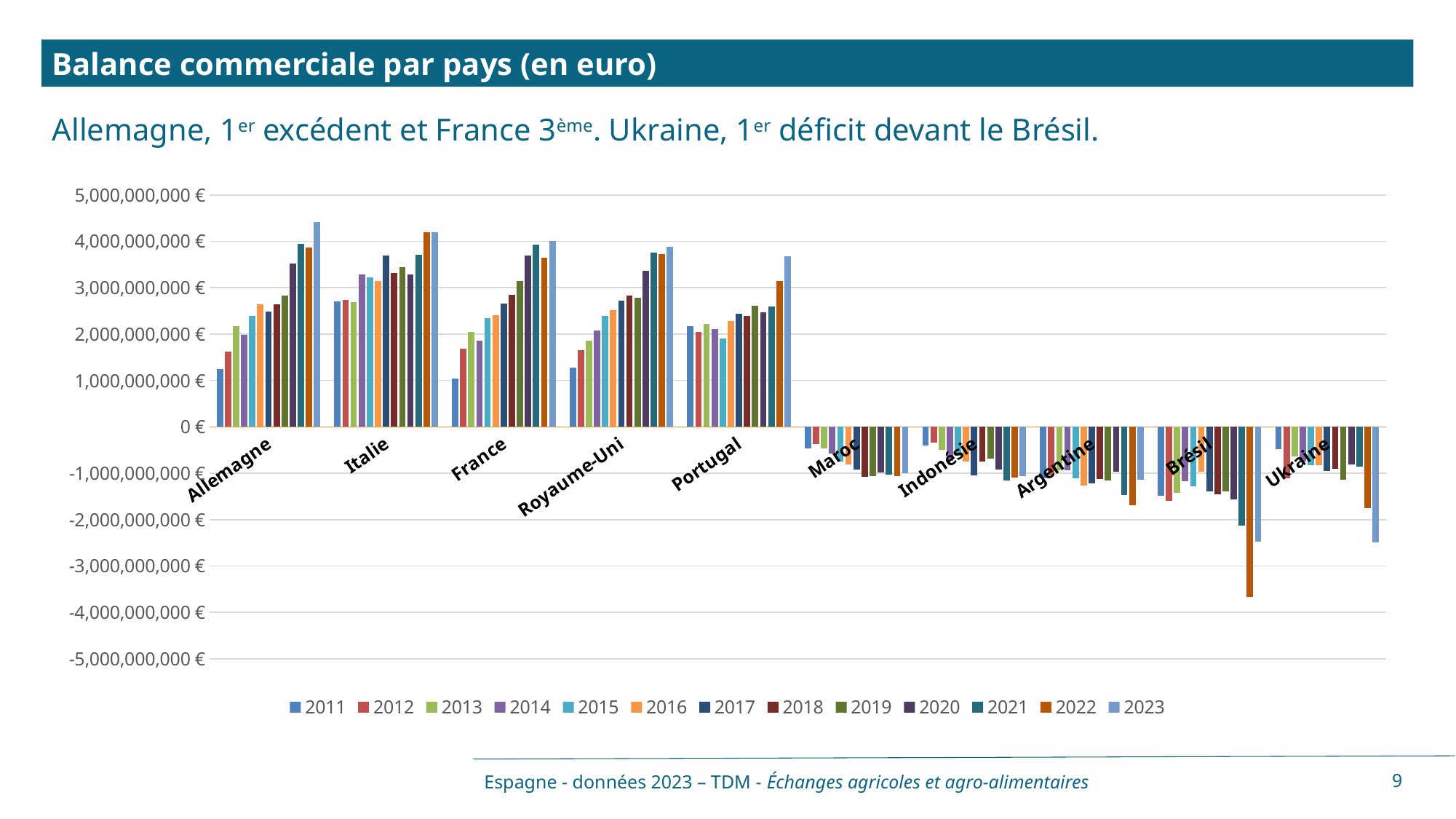
Is the value for Brésil in 2022 greater or less than -3,000,000,000 €? less Which is lower in 2022: Ukraine or Brésil? Brésil How many countries are shown on the x axis? 10 Is the value for Indonésie in 2011 greater or less than -1,000,000,000 €? greater Which is larger for Allemagne: the 2011 value or the 2023 value? 2023 How many series (years) does the legend list? 13 What kind of chart is shown on the slide? bar chart What is the title of the chart on the slide? Balance commerciale par pays (en euro) Is the value for Portugal in 2023 greater or less than 3,000,000,000 €? greater How many countries have negative (deficit) values in the chart? 5 Which country has the lowest value for 2022? Brésil